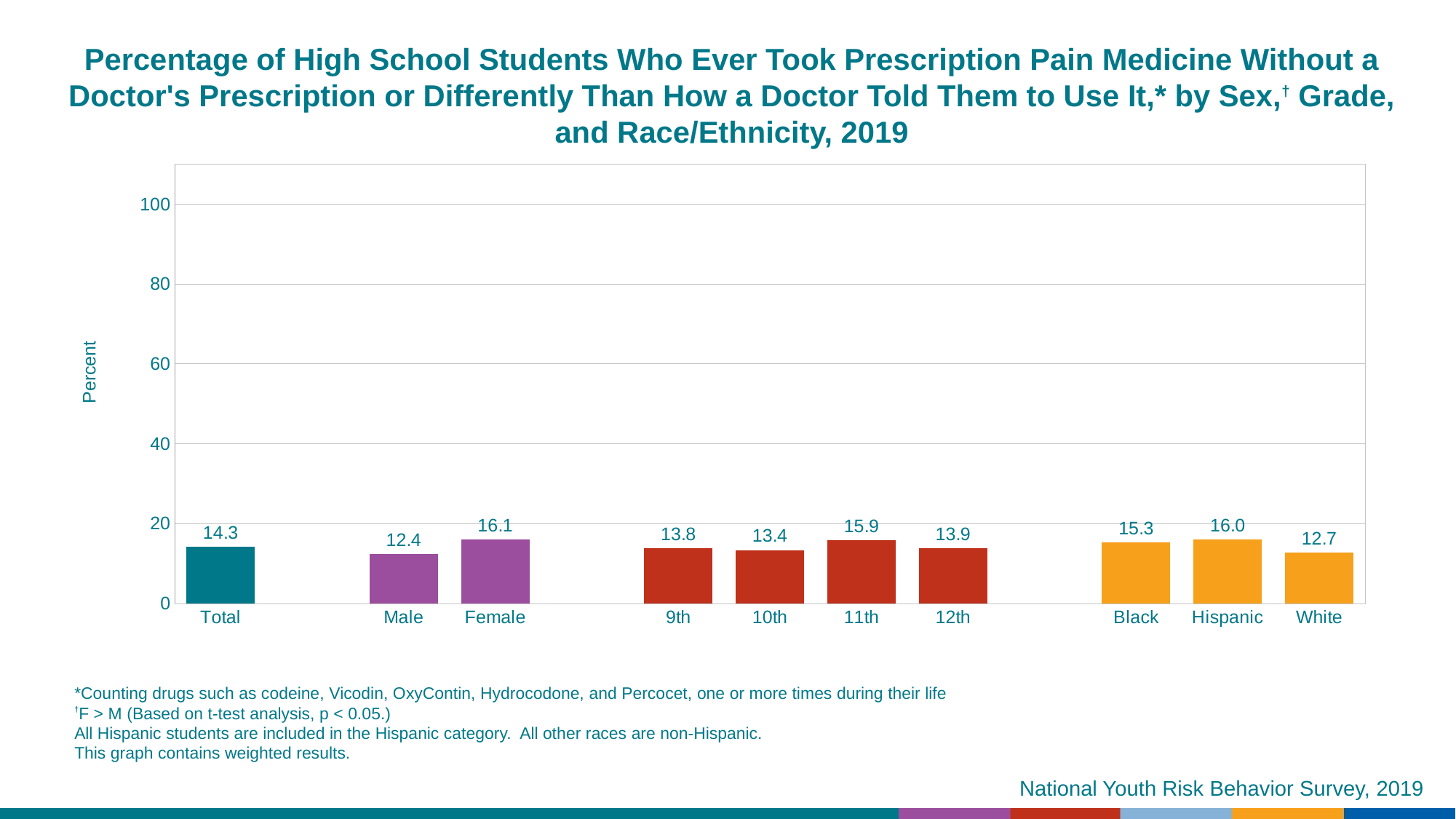
How many categories are shown on the x axis? 10 What is the value for Hispanic students? 16.0 Which is larger, the value for 11th grade or 12th grade? 11th What is the value for 10th grade? 13.4 Which category has the highest value? Female What is the value for Total? 14.3 Is the value for Black students greater or less than 20? less What is the value for Female? 16.1 What is the label on the y axis? Percent Which category has the lowest value? Male What kind of chart is shown? bar chart What is the difference between the Female and Male values? 3.7